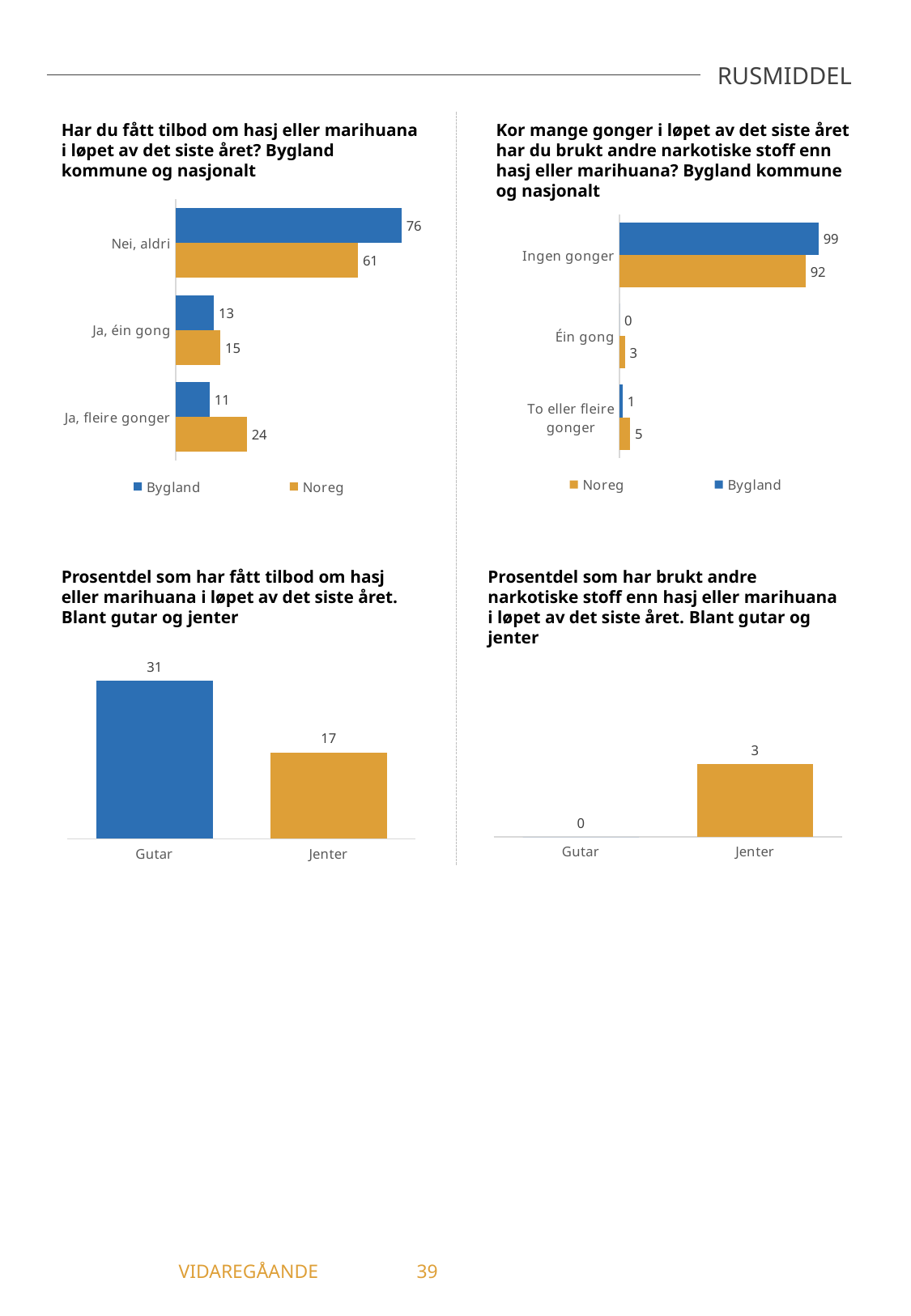
In the top-left chart (Har du fått tilbod om hasj eller marihuana...), which is larger for 'Ja, éin gong': Bygland or Noreg? Noreg In the top-right chart (Kor mange gonger i løpet av det siste året har du brukt andre narkotiske stoff...), what is the Bygland value for 'Ingen gonger'? 99 In the bottom-left chart (Prosentdel som har fått tilbod om hasj eller marihuana...), what is the difference between Gutar and Jenter? 14 In the top-right chart (Kor mange gonger i løpet av det siste året har du brukt andre narkotiske stoff...), how many categories are shown? 3 In the top-right chart (Kor mange gonger i løpet av det siste året har du brukt andre narkotiske stoff...), what is the Noreg value for 'To eller fleire gonger'? 5 How many series does the legend of the top-left chart (Har du fått tilbod om hasj eller marihuana...) list? 2 In the bottom-left chart (Prosentdel som har fått tilbod om hasj eller marihuana...), what is the value for Gutar? 31 In the bottom-right chart (Prosentdel som har brukt andre narkotiske stoff...), which category has the highest value? Jenter What kind of chart is the top-right chart (Kor mange gonger i løpet av det siste året har du brukt andre narkotiske stoff...)? Bar chart In the top-left chart (Har du fått tilbod om hasj eller marihuana...), what is the Bygland value for 'Nei, aldri'? 76 In the top-left chart (Har du fått tilbod om hasj eller marihuana...), what is the Noreg value for 'Ja, fleire gonger'? 24 In the top-left chart (Har du fått tilbod om hasj eller marihuana...), what is the difference between the Bygland and Noreg values for 'Nei, aldri'? 15